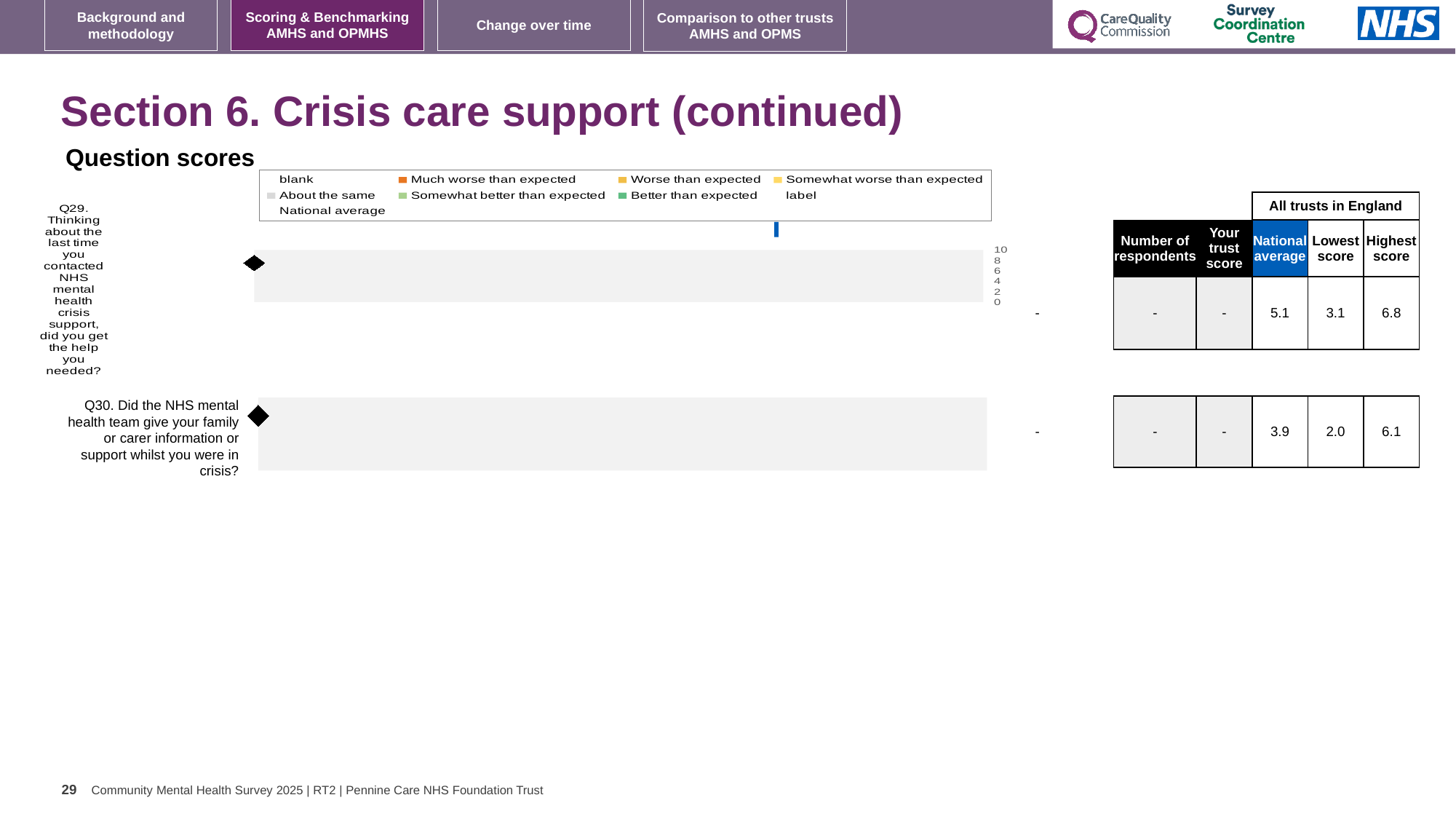
What is the national average score for Q29 in the table? 5.1 What is the highest tick value shown on the chart's score axis? 10 How many survey questions are plotted in the question scores chart? 2 What is the highest score across all trusts in England for Q30? 6.1 What kind of chart is used on the slide for the question scores? bar chart What is the lowest score across all trusts in England for Q29? 3.1 What colour does the legend use for 'Much worse than expected'? orange What is the national average score for Q30 in the table? 3.9 What is the difference between the highest score and the lowest score for Q29? 3.7 What is the difference between the highest score and the lowest score for Q30? 4.1 What is shown as the trust's own score for Q29? - Which question has the higher national average, Q29 or Q30? Q29